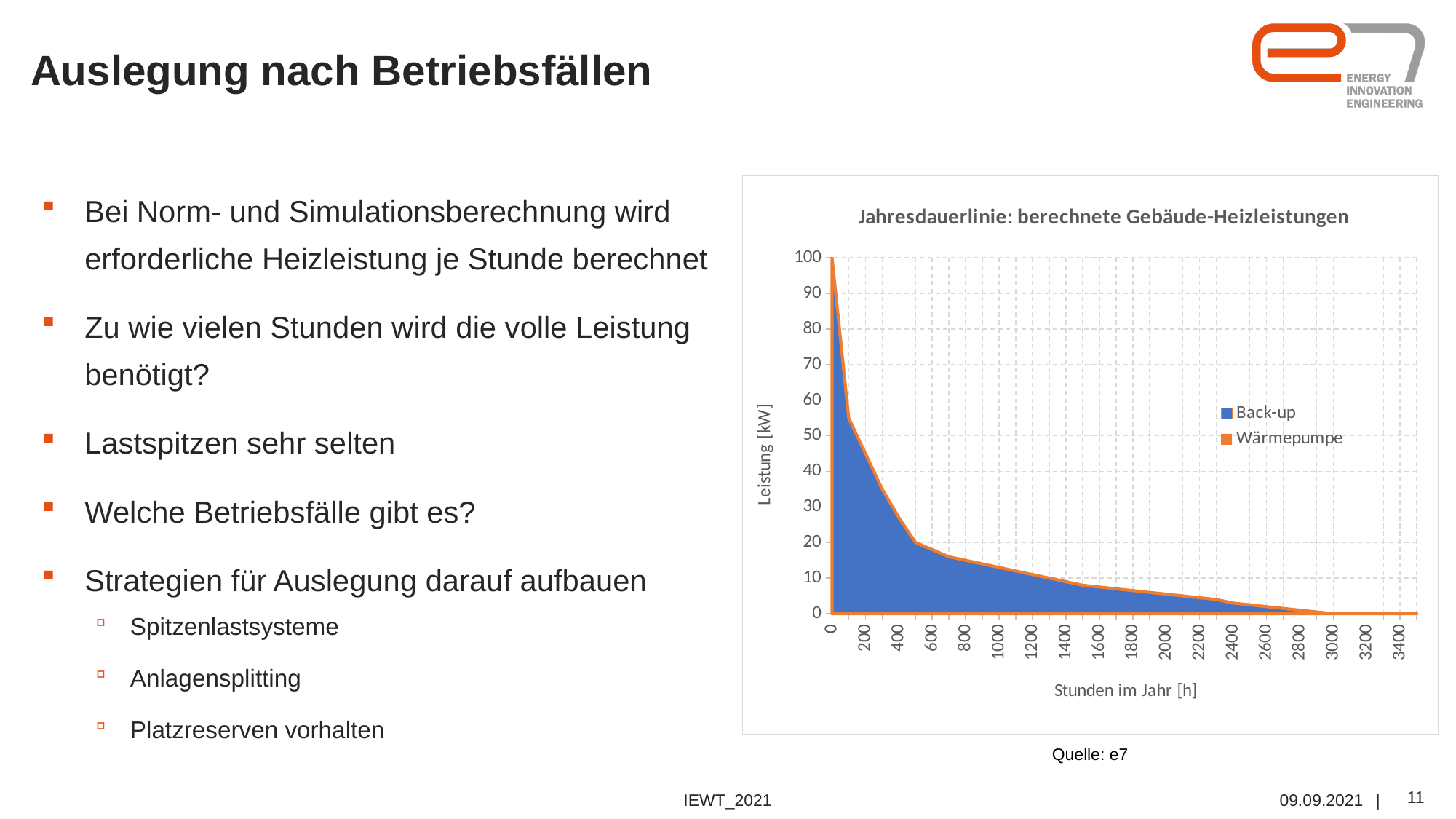
What kind of chart is shown on the slide? area chart What is the maximum value shown on the y axis of the chart? 100 Is the plotted heating power at 1000 hours greater or less than 20 kW? less Is the plotted heating power at 400 hours greater or less than 20 kW? greater Is the plotted heating power at 2000 hours greater or less than 10 kW? less What is the label of the x axis of the chart? Stunden im Jahr [h] How many series does the chart legend list? 2 What is the title of the chart? Jahresdauerlinie: berechnete Gebäude-Heizleistungen Do the plotted values rise or fall as the hours in the year increase along the x axis? fall